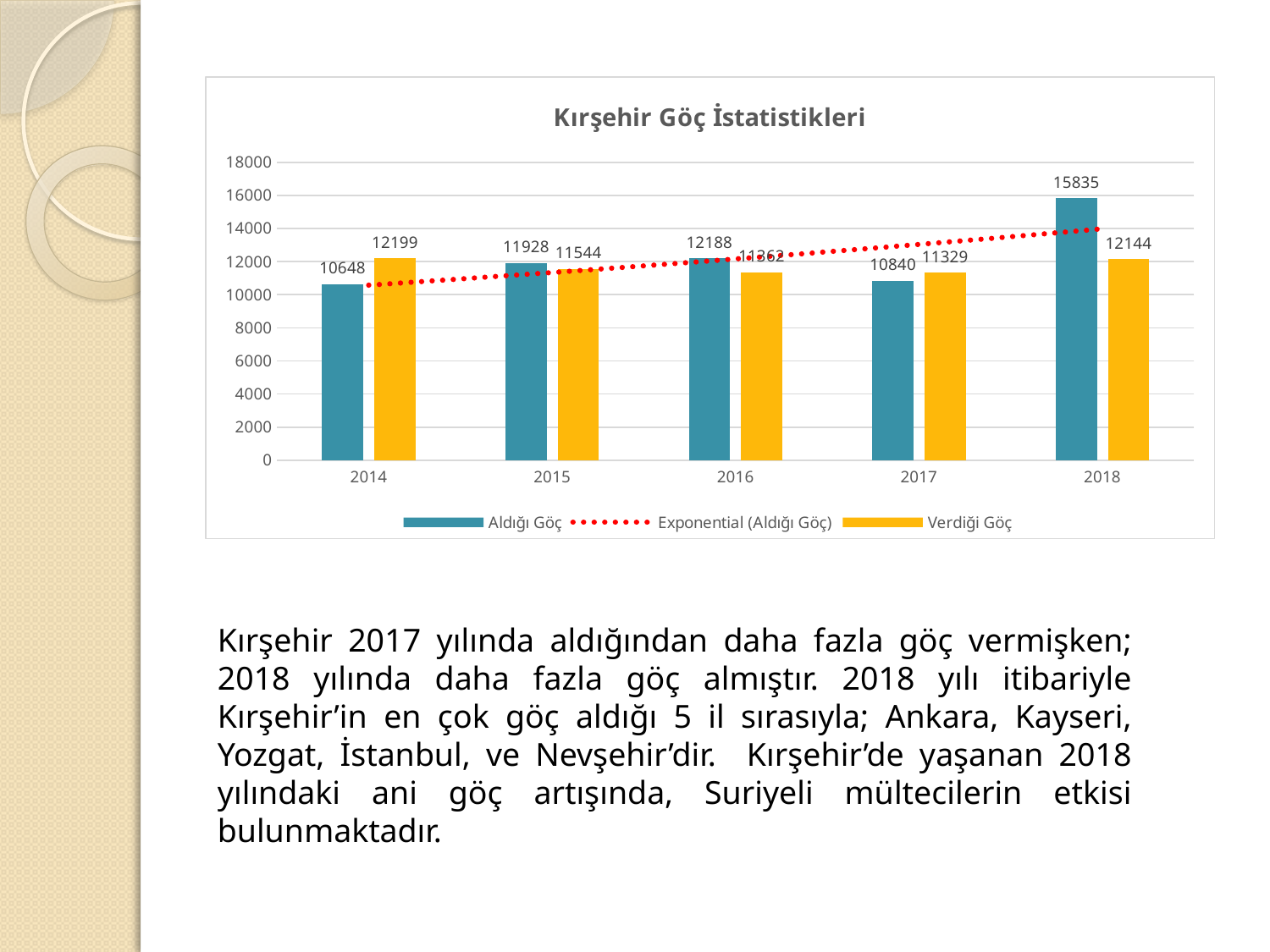
What is the difference between Aldığı Göç and Verdiği Göç in 2018? 3691 How many years are shown on the x axis? 5 What is the value of Verdiği Göç for 2014? 12199 What is the difference between Verdiği Göç and Aldığı Göç in 2014? 1551 What is the value of Aldığı Göç for 2015? 11928 How many entries does the legend list? 3 In which year is Aldığı Göç the highest? 2018 What is the value of Aldığı Göç for 2018? 15835 Is the value of Verdiği Göç for 2017 greater or less than 12000? less What is the title of the chart? Kırşehir Göç İstatistikleri In which year is Aldığı Göç the lowest? 2014 In 2017, which is larger: Aldığı Göç or Verdiği Göç? Verdiği Göç